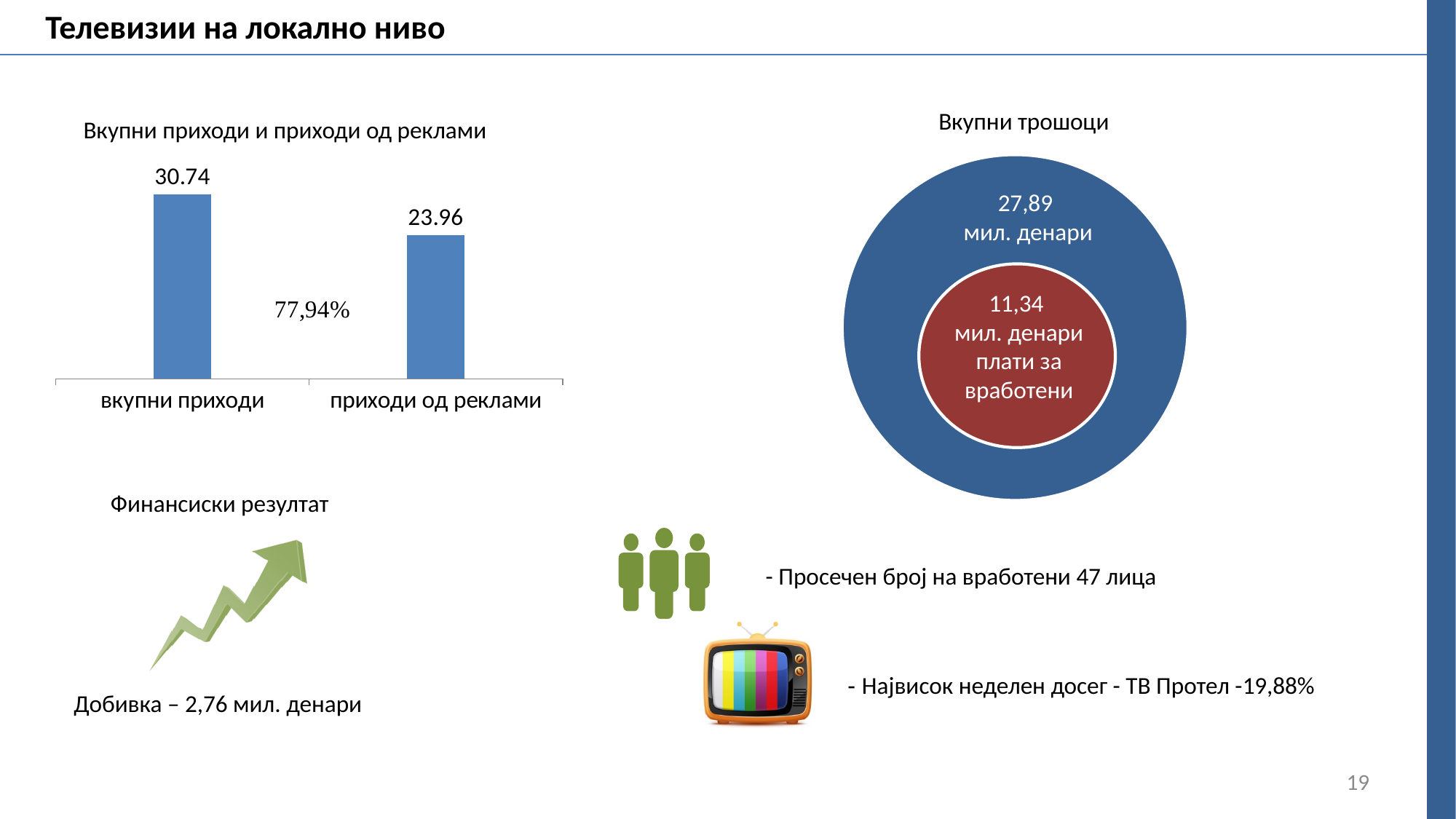
In the chart 'Вкупни приходи и приходи од реклами', what is the difference between 'вкупни приходи' and 'приходи од реклами'? 6.78 In the chart 'Вкупни приходи и приходи од реклами', what is the value for 'вкупни приходи'? 30.74 In the chart 'Вкупни приходи и приходи од реклами', which category has the lowest value? приходи од реклами In the chart 'Вкупни приходи и приходи од реклами', which is larger: 'вкупни приходи' or 'приходи од реклами'? вкупни приходи How many categories are shown in the chart 'Вкупни приходи и приходи од реклами'? 2 In the chart 'Вкупни приходи и приходи од реклами', what is the value for 'приходи од реклами'? 23.96 In the chart 'Вкупни приходи и приходи од реклами', do the values rise or fall from left to right? fall What is the title of the bar chart on the left of the slide? Вкупни приходи и приходи од реклами What percentage is printed between the two bars in the chart 'Вкупни приходи и приходи од реклами'? 77,94% In the chart 'Вкупни приходи и приходи од реклами', which category has the highest value? вкупни приходи What type of chart is 'Вкупни приходи и приходи од реклами'? bar chart